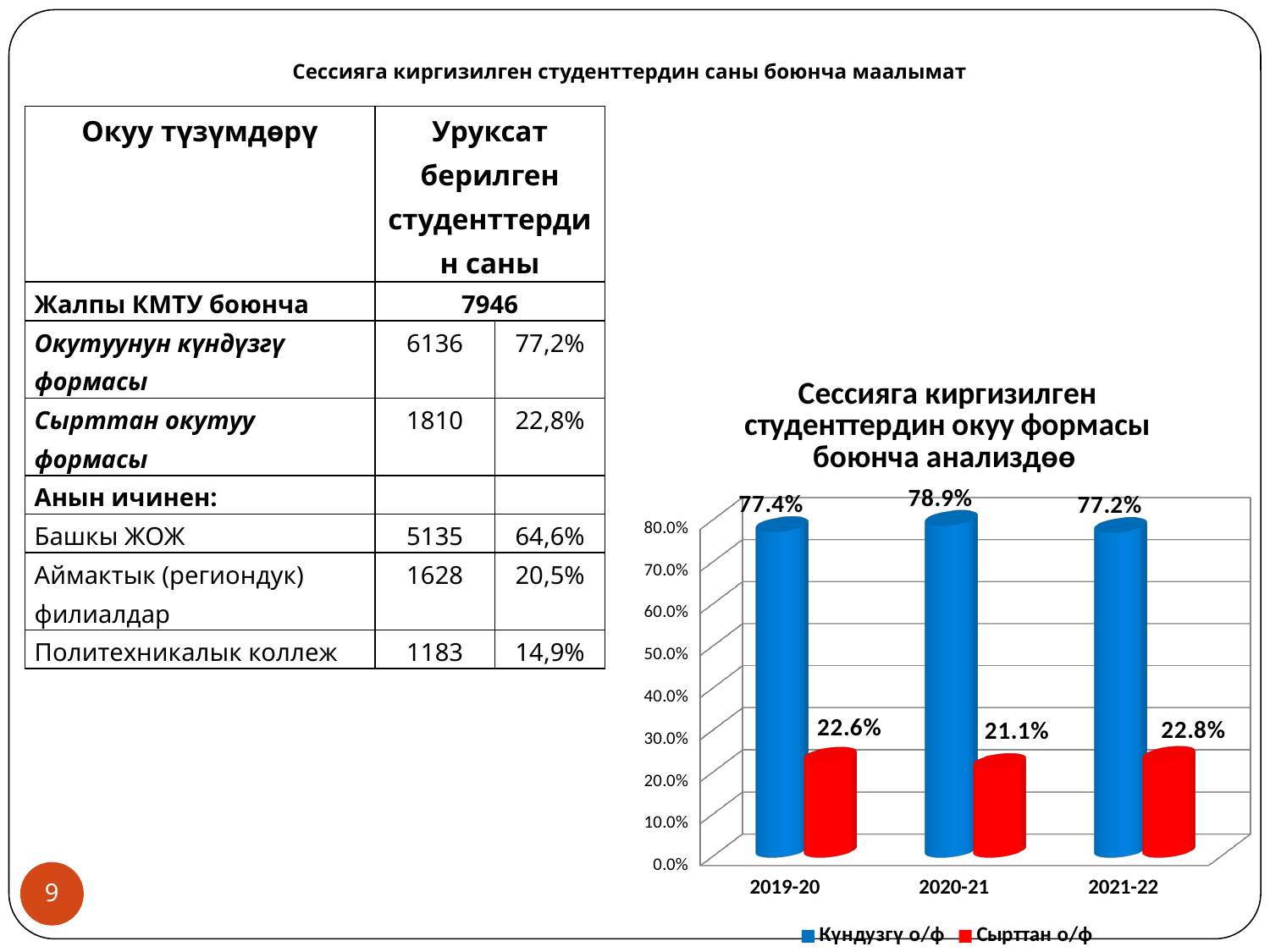
In which year is the Сырттан о/ф value lowest? 2020-21 What colour are the Сырттан о/ф bars in the chart? red In which year is the Күндузгү о/ф value highest? 2020-21 What is the value for Сырттан о/ф in 2019-20? 22.6% How many series does the chart legend list? 2 Is the value for Сырттан о/ф in 2020-21 greater or less than 30.0%? less How many years are shown on the x axis of the chart? 3 What is the value for Сырттан о/ф in 2021-22? 22.8% What is the value for Күндузгү о/ф in 2020-21? 78.9% What is the difference between the Күндузгү о/ф and Сырттан о/ф values in 2021-22? 54.4% What kind of chart is shown on the slide? bar chart Which is larger in 2019-20: Күндузгү о/ф or Сырттан о/ф? Күндузгү о/ф